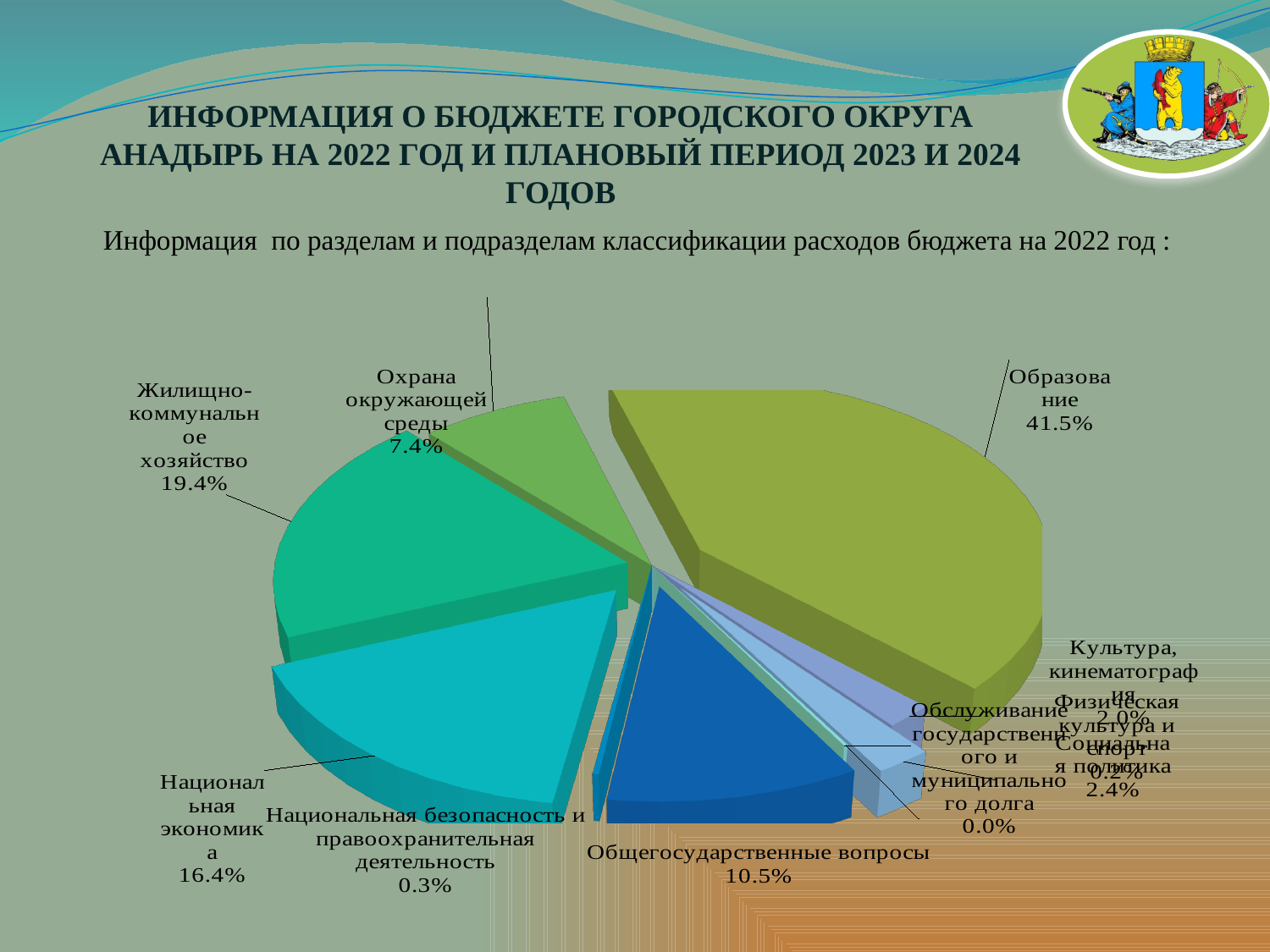
What percentage is shown for Жилищно-коммунальное хозяйство? 19.4% What percentage is shown for Национальная экономика? 16.4% What share of the 2022 budget expenditure goes to Образование? 41.5% What percentage is shown for Национальная безопасность и правоохранительная деятельность? 0.3% Which section has the largest share of the budget expenditure? Образование Which is larger, the share for Национальная экономика or the share for Общегосударственные вопросы? Национальная экономика What kind of chart is shown on the slide? pie chart What is the difference in percentage points between Образование and Жилищно-коммунальное хозяйство? 22.1 What percentage is shown for Обслуживание государственного и муниципального долга? 0.0% What percentage is shown for Общегосударственные вопросы? 10.5% What percentage is shown for Охрана окружающей среды? 7.4% Which section has the smallest share of the budget expenditure? Обслуживание государственного и муниципального долга